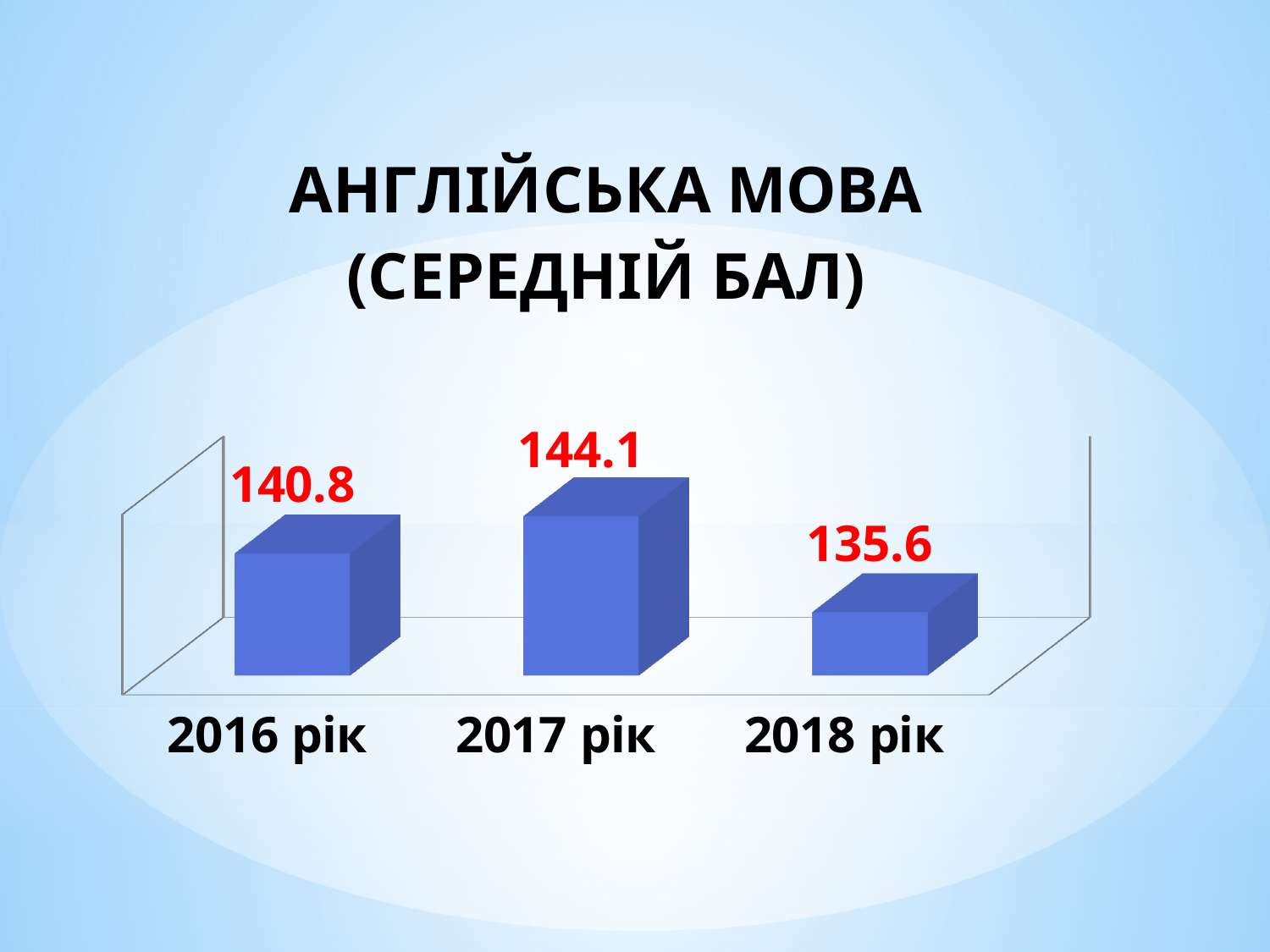
Which year has the highest value? 2017 рік What is the difference between the values for 2017 рік and 2018 рік? 8.5 How many years are shown on the chart? 3 Which year has the lowest value? 2018 рік Which is larger, the value for 2016 рік or the value for 2018 рік? 2016 рік Does the value rise or fall from 2017 рік to 2018 рік? fall What is the value for 2016 рік? 140.8 What is the value for 2018 рік? 135.6 What is the title of the chart? АНГЛІЙСЬКА МОВА (СЕРЕДНІЙ БАЛ) What is the difference between the values for 2017 рік and 2016 рік? 3.3 What is the value for 2017 рік? 144.1 What kind of chart is shown on the slide? bar chart